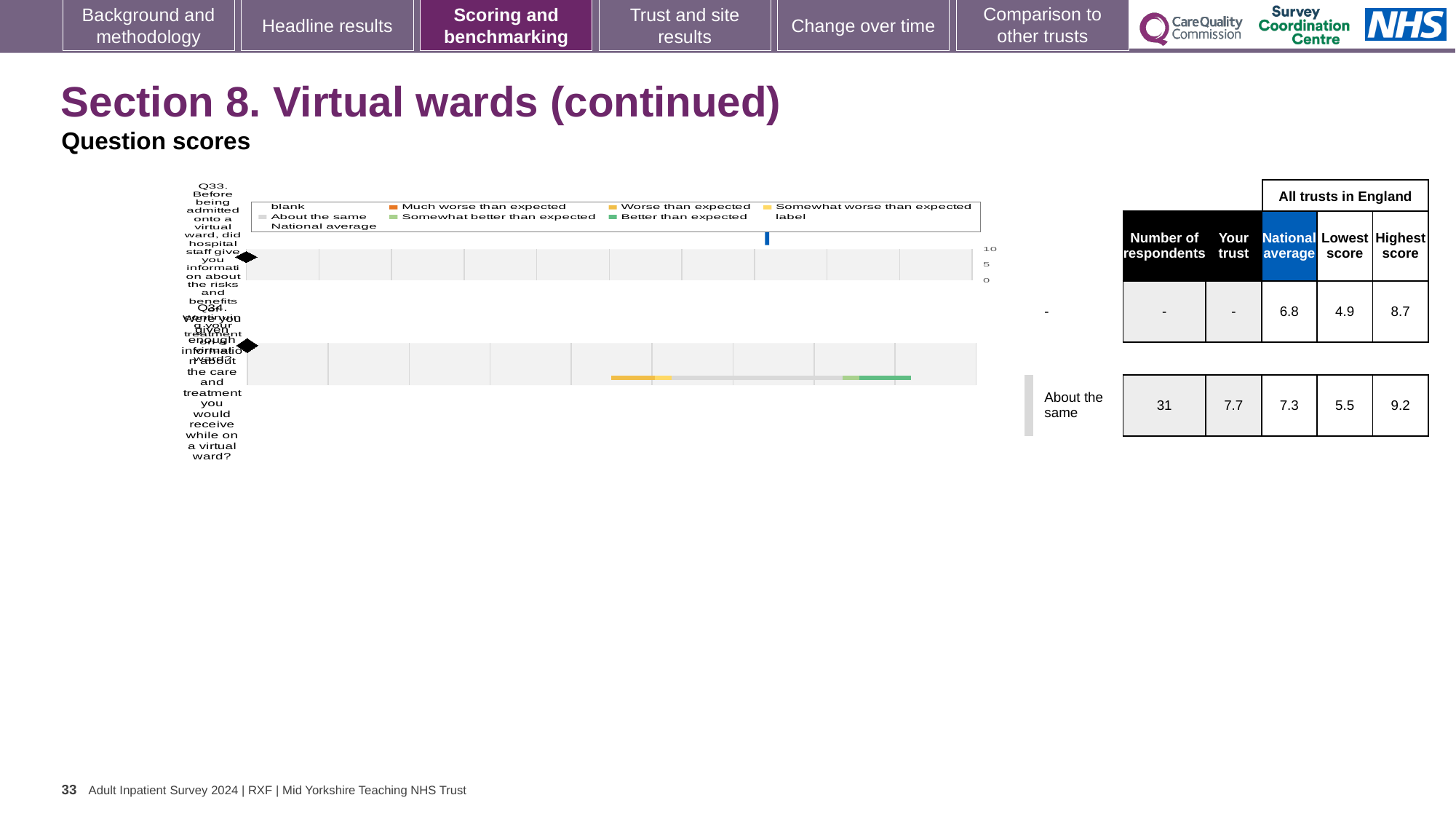
In the table next to the chart, what is the national average for Q34? 7.3 In the table next to the chart, what is the 'Your trust' score for Q34? 7.7 In the table next to the chart, what is the national average for Q33? 6.8 For Q34, is the 'Your trust' score larger or smaller than the national average? larger In the table next to the chart, what is the lowest score across all trusts in England for Q33? 4.9 In the table next to the chart, how many respondents are listed for Q34? 31 What kind of chart is shown on the slide? bar chart How many questions (categories) are plotted on the chart? 2 In the table next to the chart, what is the highest score across all trusts in England for Q34? 9.2 What is the maximum value shown on the chart's scale? 10 For Q34, what is the difference between the highest score and the lowest score across all trusts in England? 3.7 What benchmark category is shown for Q34 beside the chart? About the same